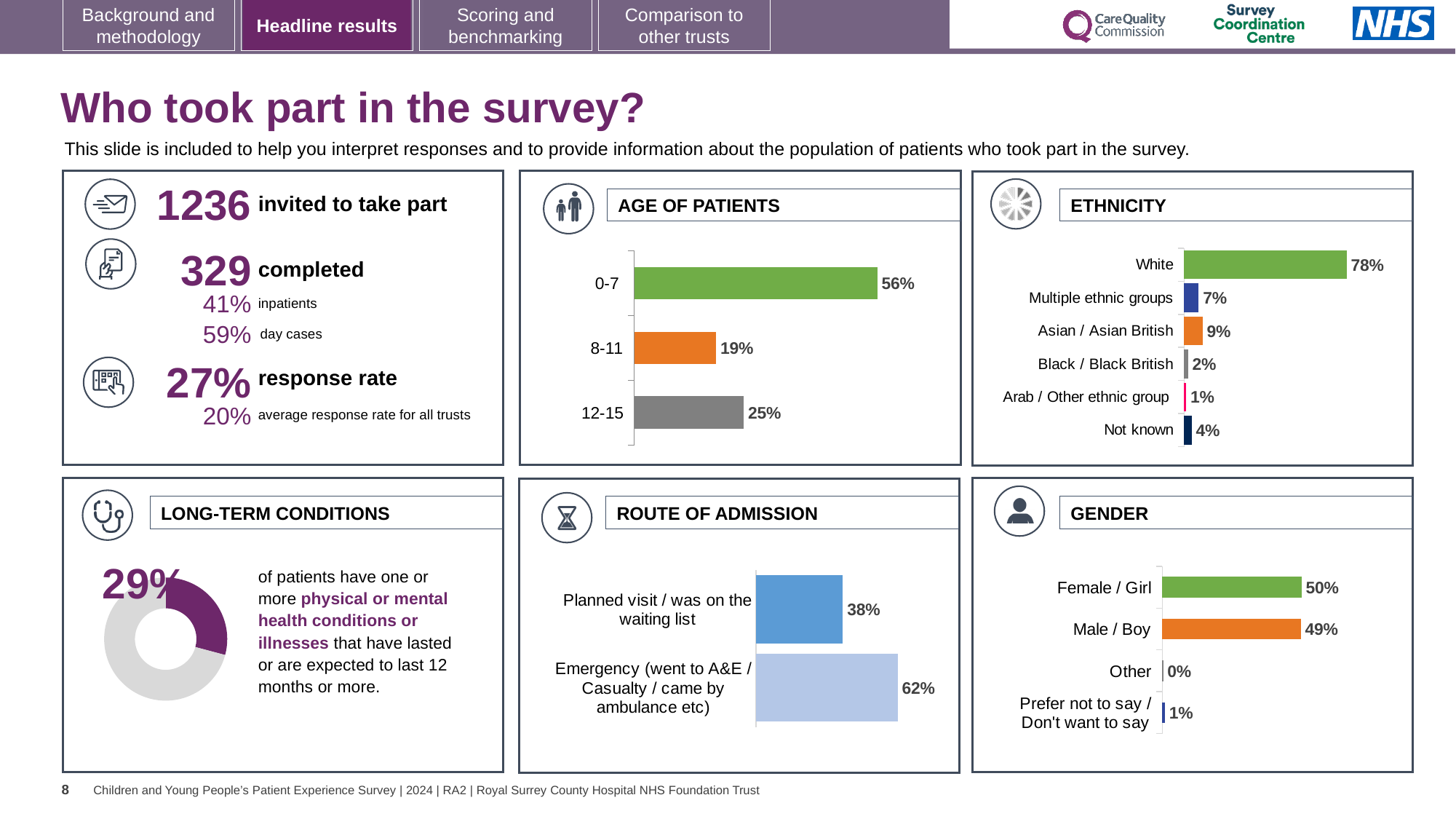
In the GENDER chart, what percentage of patients were Male / Boy? 49% In the ETHNICITY chart, how many ethnicity categories are shown? 6 In the GENDER chart, which category has the highest percentage? Female / Girl What kind of chart is used in the LONG-TERM CONDITIONS panel? Doughnut chart In the AGE OF PATIENTS chart, what is the difference between the 12-15 and 8-11 percentages? 6% In the ROUTE OF ADMISSION chart, what is the difference between the Emergency and Planned visit percentages? 24% In the AGE OF PATIENTS chart, which age group has the lowest percentage? 8-11 In the ROUTE OF ADMISSION chart, what percentage of patients came via Emergency (went to A&E / Casualty / came by ambulance etc)? 62% In the ETHNICITY chart, what percentage of patients were White? 78% In the AGE OF PATIENTS chart, what percentage of patients were aged 0-7? 56% In the ETHNICITY chart, which is larger: Asian / Asian British or Multiple ethnic groups? Asian / Asian British In the ETHNICITY chart, which category has the lowest percentage? Arab / Other ethnic group